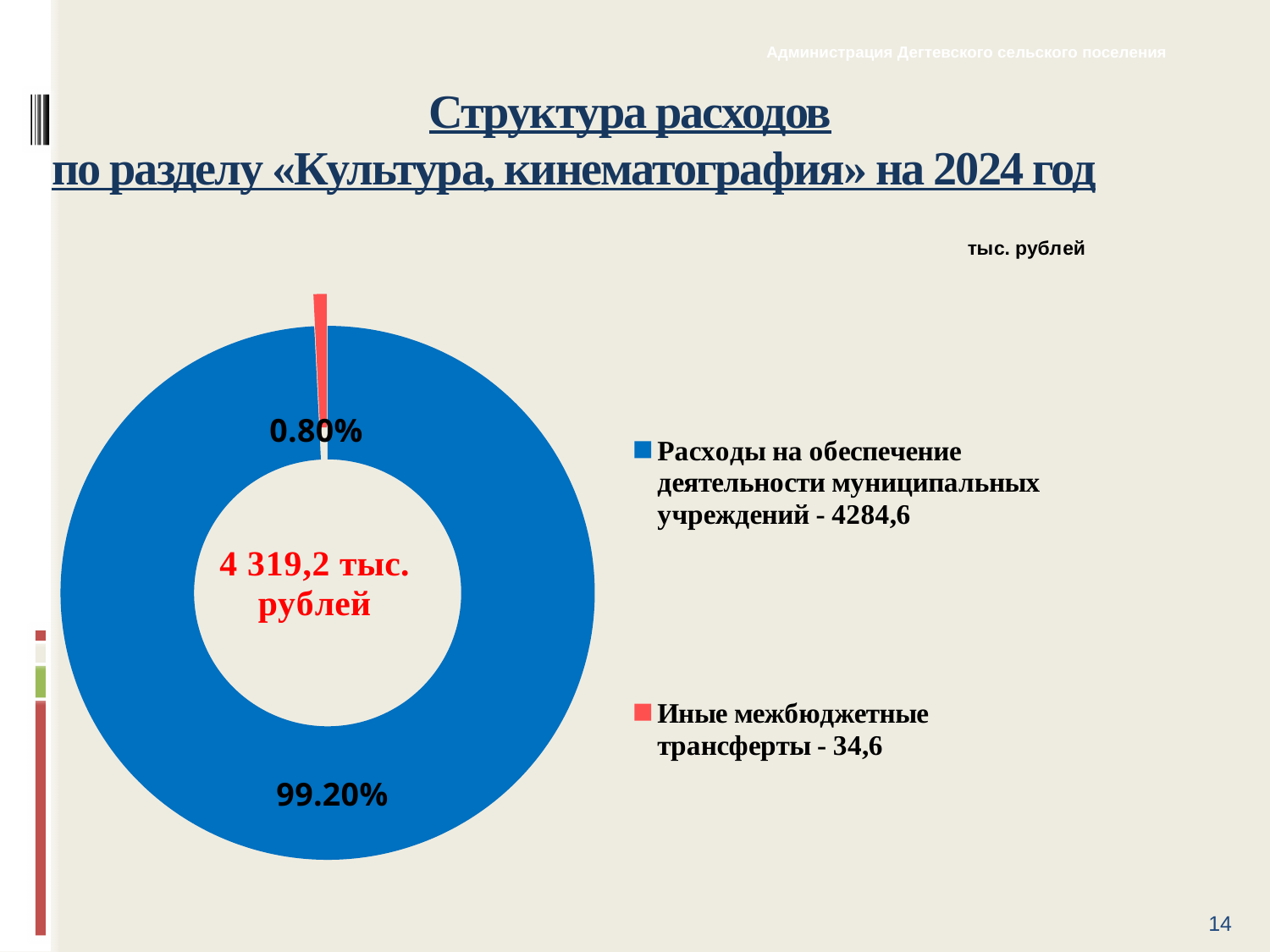
What percentage share does the slice for "Иные межбюджетные трансферты" have? 0.80% What percentage share does the slice for "Расходы на обеспечение деятельности муниципальных учреждений" have? 99.20% Which category has the smallest share of the chart? Иные межбюджетные трансферты How many categories does the chart show? 2 What total amount is shown in the centre of the chart? 4 319,2 тыс. рублей What is the difference between the values 4284,6 and 34,6 shown in the legend? 4250 Which category has the largest share of the chart? Расходы на обеспечение деятельности муниципальных учреждений What colour is the slice for "Иные межбюджетные трансферты"? Red What value is given in the legend for "Расходы на обеспечение деятельности муниципальных учреждений"? 4284,6 What value is given in the legend for "Иные межбюджетные трансферты"? 34,6 What kind of chart is shown on the slide? Doughnut (pie) chart Which is larger: the value for "Расходы на обеспечение деятельности муниципальных учреждений" or for "Иные межбюджетные трансферты"? Расходы на обеспечение деятельности муниципальных учреждений